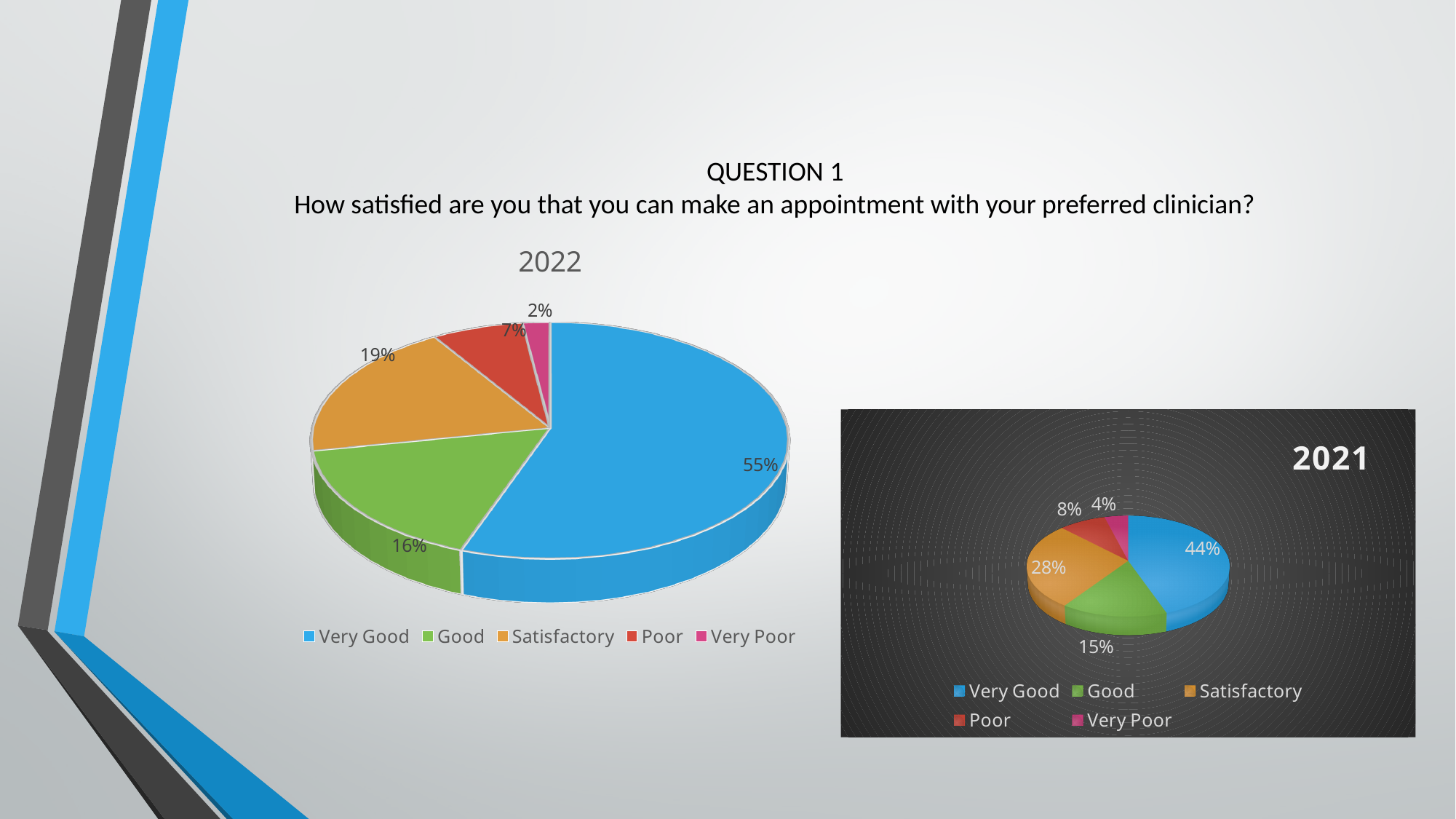
In the 2022 chart, which category has the largest slice? Very Good In the 2021 chart, which category has the smallest slice? Very Poor How many categories does the legend of the 2022 chart list? 5 What is the difference between the Very Good share in the 2022 chart and the Very Good share in the 2021 chart? 11% In the 2021 chart, what percentage of respondents answered Satisfactory? 28% In the 2022 chart, what percentage of respondents answered Very Good? 55% In the 2022 chart, what is the value for Poor? 7% In the 2022 chart, which is larger, the Satisfactory slice or the Good slice? Satisfactory In the 2021 chart, what is the value for Very Poor? 4% In the 2022 chart, what colour is the Satisfactory slice? Orange What type of chart is the 2021 chart? Pie chart In the 2021 chart, what is the difference between the Satisfactory and Good values? 13%